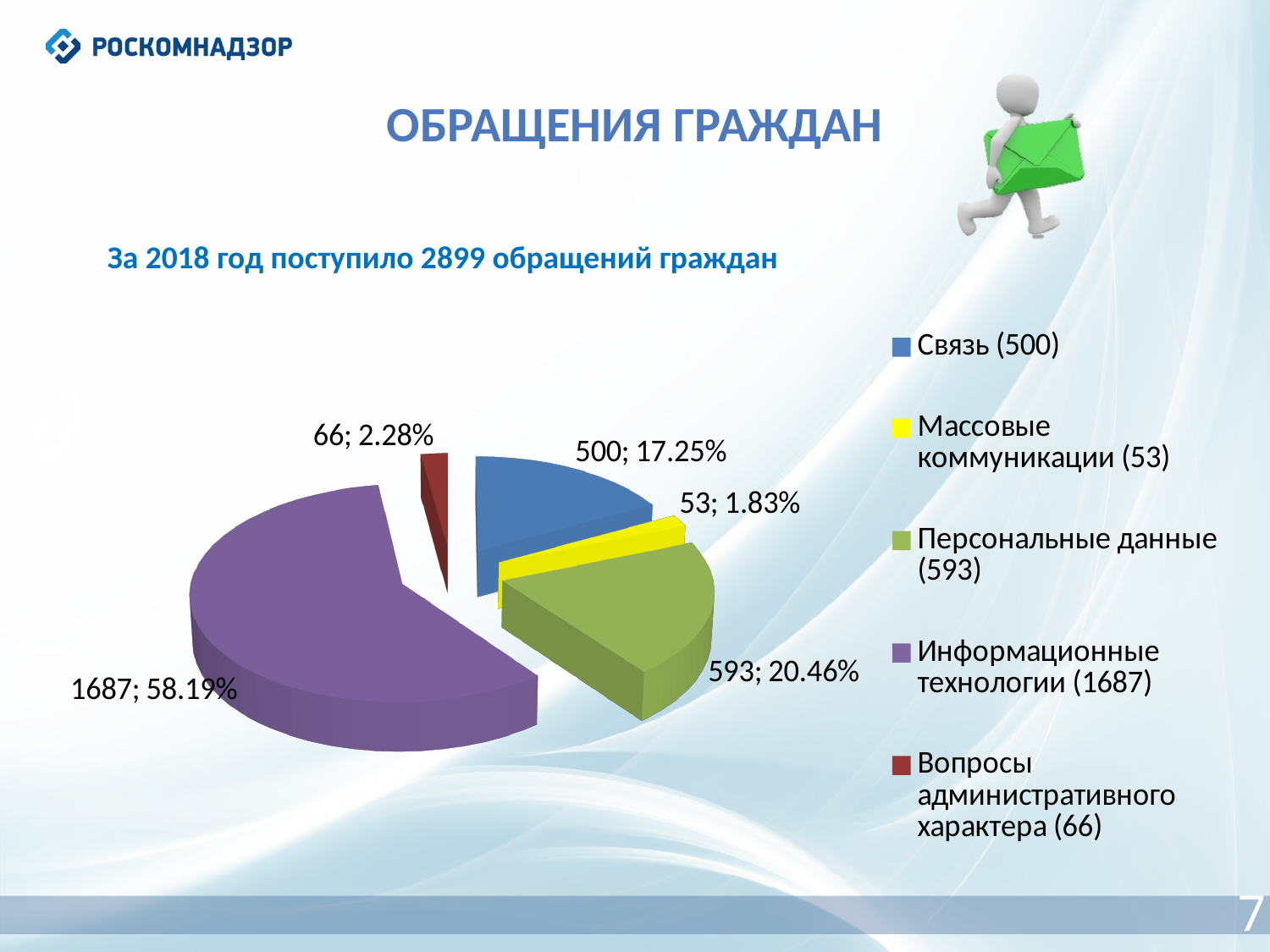
Which category has the largest slice? Информационные технологии What share of the pie does Вопросы административного характера take? 2.28% What is the difference between the values for Персональные данные and Связь? 93 Which is larger, the value for Связь or the value for Вопросы административного характера? Связь How many slices does the pie chart have? 5 What is the value for Персональные данные? 593 What is the value for Связь? 500 What is the value for Массовые коммуникации? 53 Which category has the smallest slice? Массовые коммуникации What kind of chart is shown on the slide? Pie chart What share of the pie does Информационные технологии take? 58.19% What colour is the slice for Информационные технологии? Purple